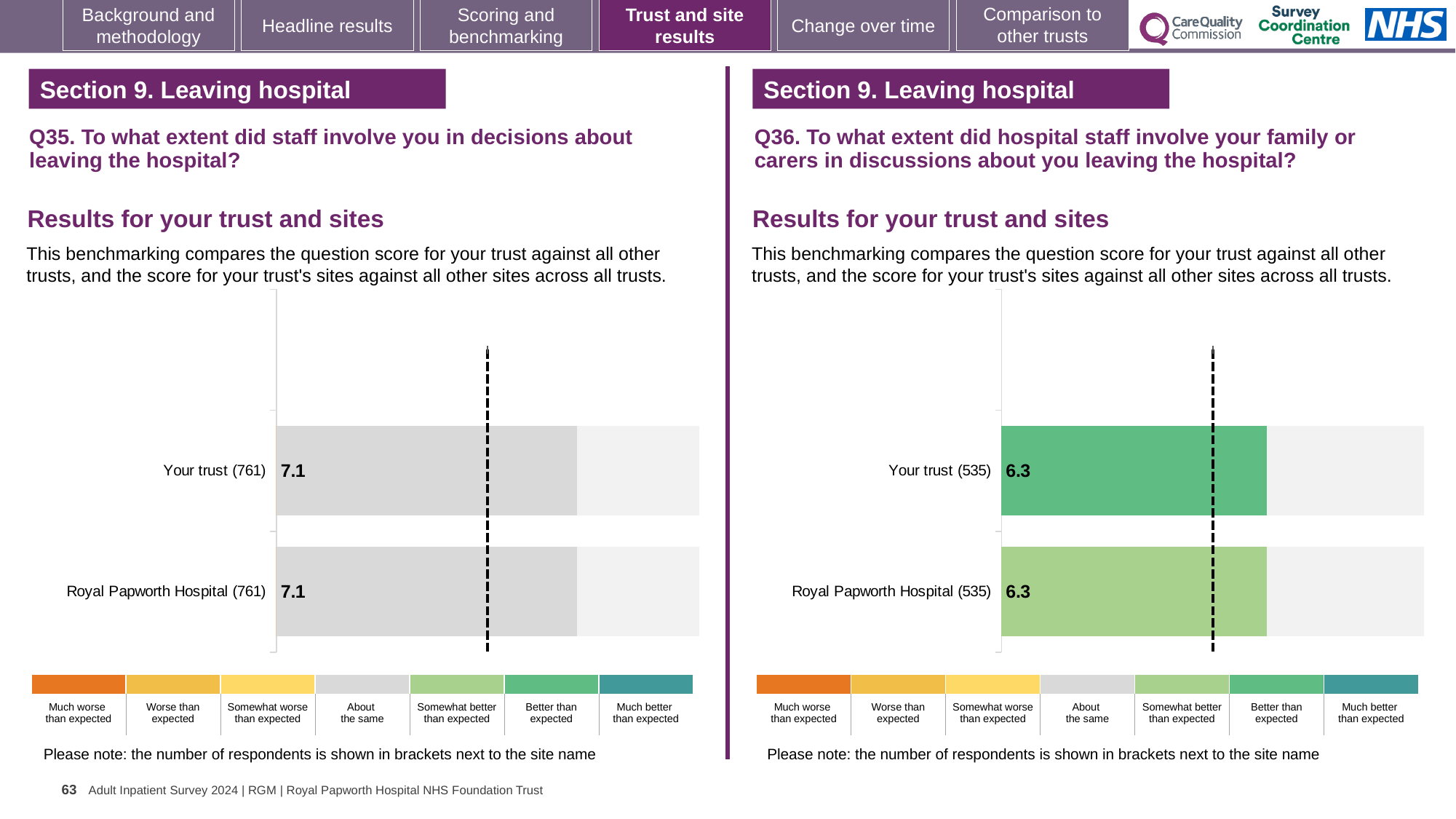
On the Q35 chart (left), what is the difference between the Your trust score and the Royal Papworth Hospital score? 0 What kind of chart is used on the Q35 chart (left)? Bar chart How many bars are plotted on the Q36 chart (right)? 2 On the Q36 chart (right), what is the difference between the Your trust score and the Royal Papworth Hospital score? 0 On the Q35 chart (left), how many respondents are shown in brackets for Your trust? 761 On the Q36 chart (right), what is the score for Royal Papworth Hospital? 6.3 On the Q36 chart (right), how many respondents are shown in brackets for Royal Papworth Hospital? 535 On the Q36 chart (right), what is the score for Your trust? 6.3 How many bars are plotted on the Q35 chart (left)? 2 Is the Your trust score on the Q36 chart (right) greater or less than the Your trust score on the Q35 chart (left)? less On the Q35 chart (left), what is the score for Royal Papworth Hospital? 7.1 On the Q35 chart (left), what is the score for Your trust? 7.1